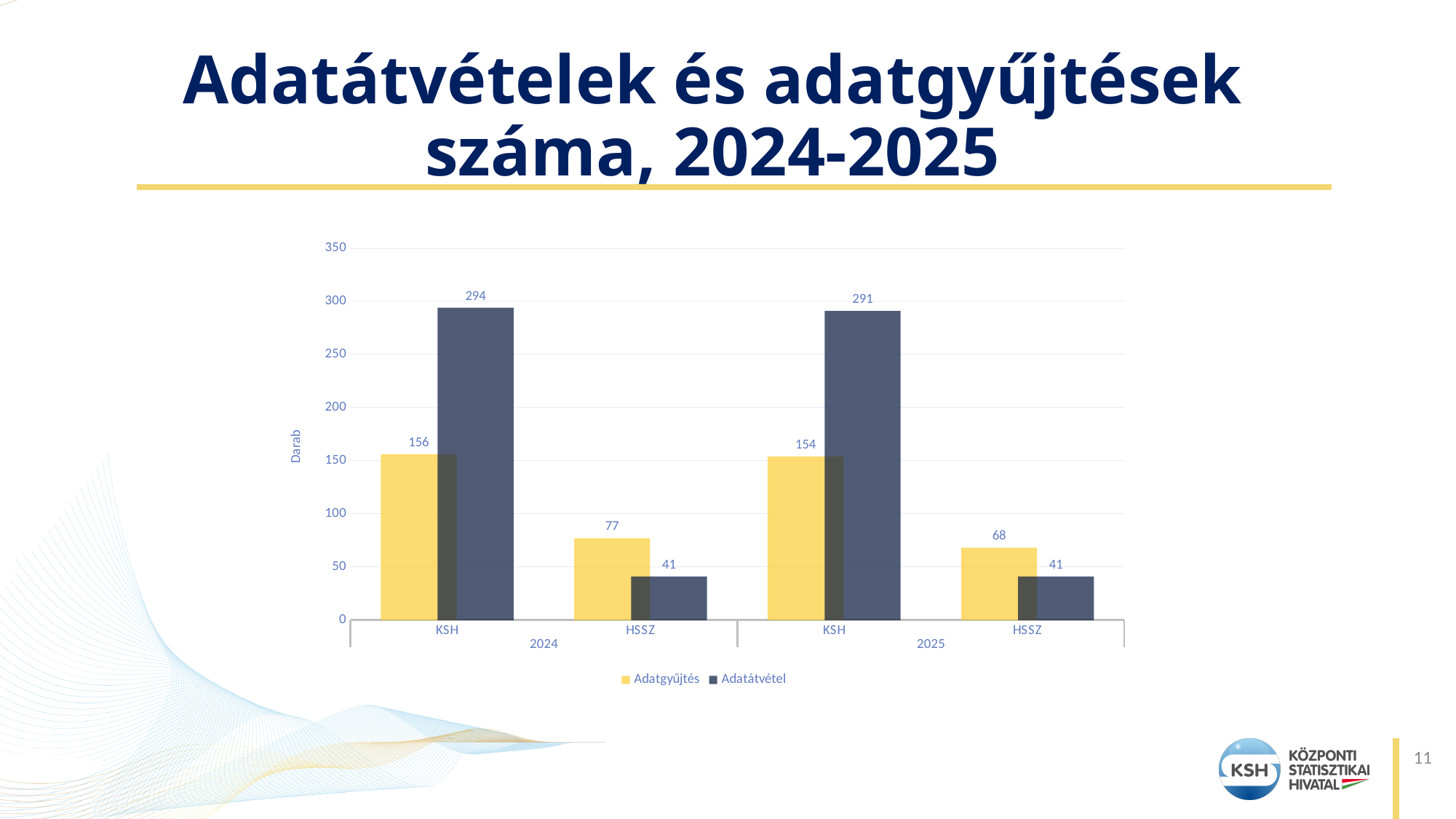
Is the Adatátvétel value for KSH in 2024 greater or less than 250? greater Which bar has the highest value on the chart? Adatátvétel, KSH 2024 (294) What kind of chart is shown on the slide? Bar chart What is the Adatátvétel value for HSSZ in 2024? 41 How many series does the legend list? 2 What is the label of the vertical axis? Darab What is the Adatátvétel value for KSH in 2025? 291 What is the difference between the Adatgyűjtés values for HSSZ in 2024 and 2025? 9 What is the difference between the Adatátvétel values for KSH in 2024 and 2025? 3 What is the Adatgyűjtés value for KSH in 2024? 156 Which is larger for HSSZ in 2024: Adatgyűjtés or Adatátvétel? Adatgyűjtés What is the Adatgyűjtés value for HSSZ in 2025? 68